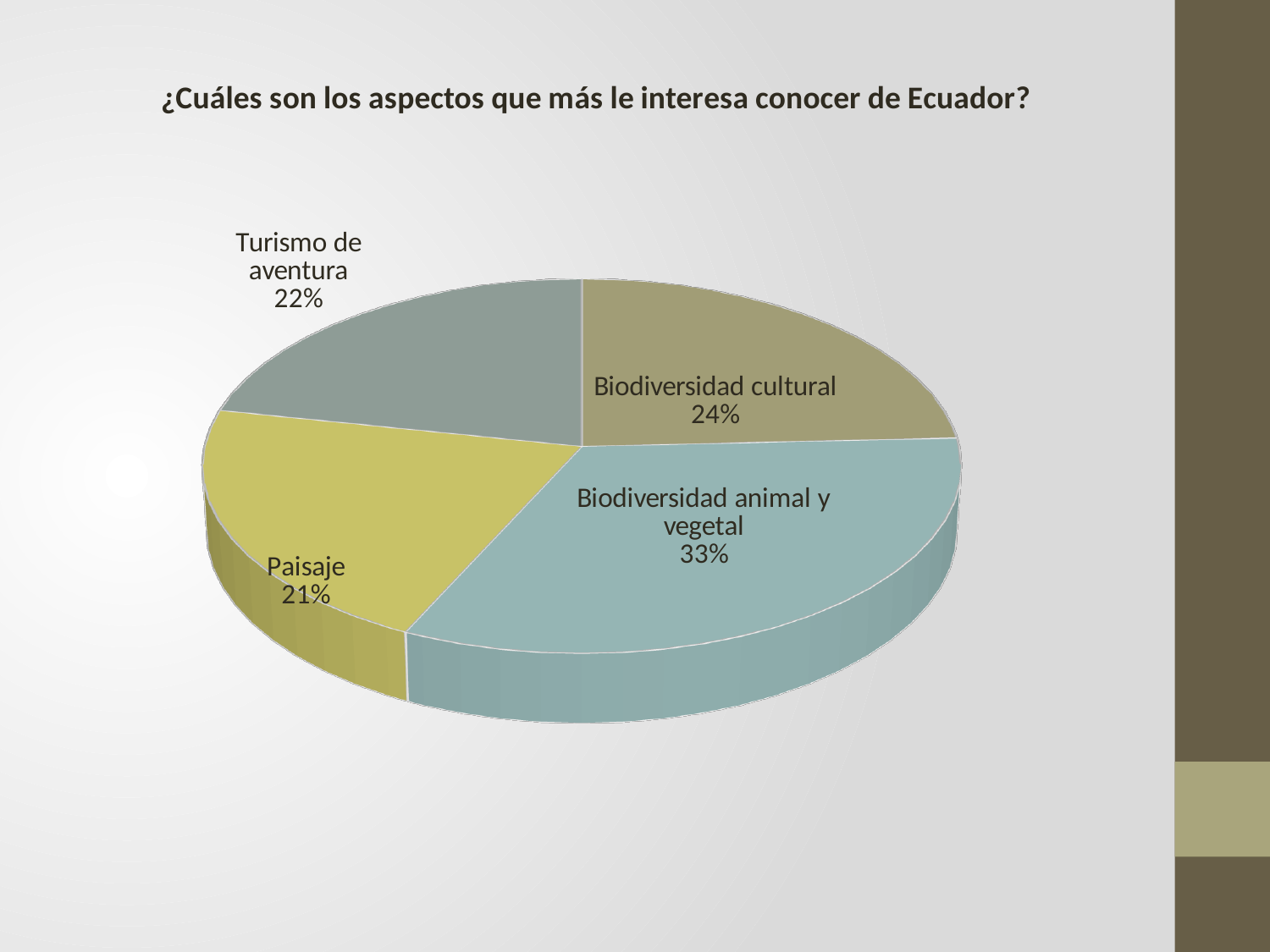
How many slices does the pie chart have? 4 Which is larger, the share for Biodiversidad cultural or the share for Turismo de aventura? Biodiversidad cultural What share of the pie does Biodiversidad animal y vegetal have? 33% What is the title of the chart? ¿Cuáles son los aspectos que más le interesa conocer de Ecuador? Which category has the smallest share of the pie? Paisaje What share of the pie does Turismo de aventura have? 22% What is the difference in percentage points between Biodiversidad animal y vegetal and Biodiversidad cultural? 9 What is the difference in percentage points between Turismo de aventura and Paisaje? 1 What kind of chart is shown on the slide? pie chart Which category has the largest share of the pie? Biodiversidad animal y vegetal What share of the pie does Paisaje have? 21%